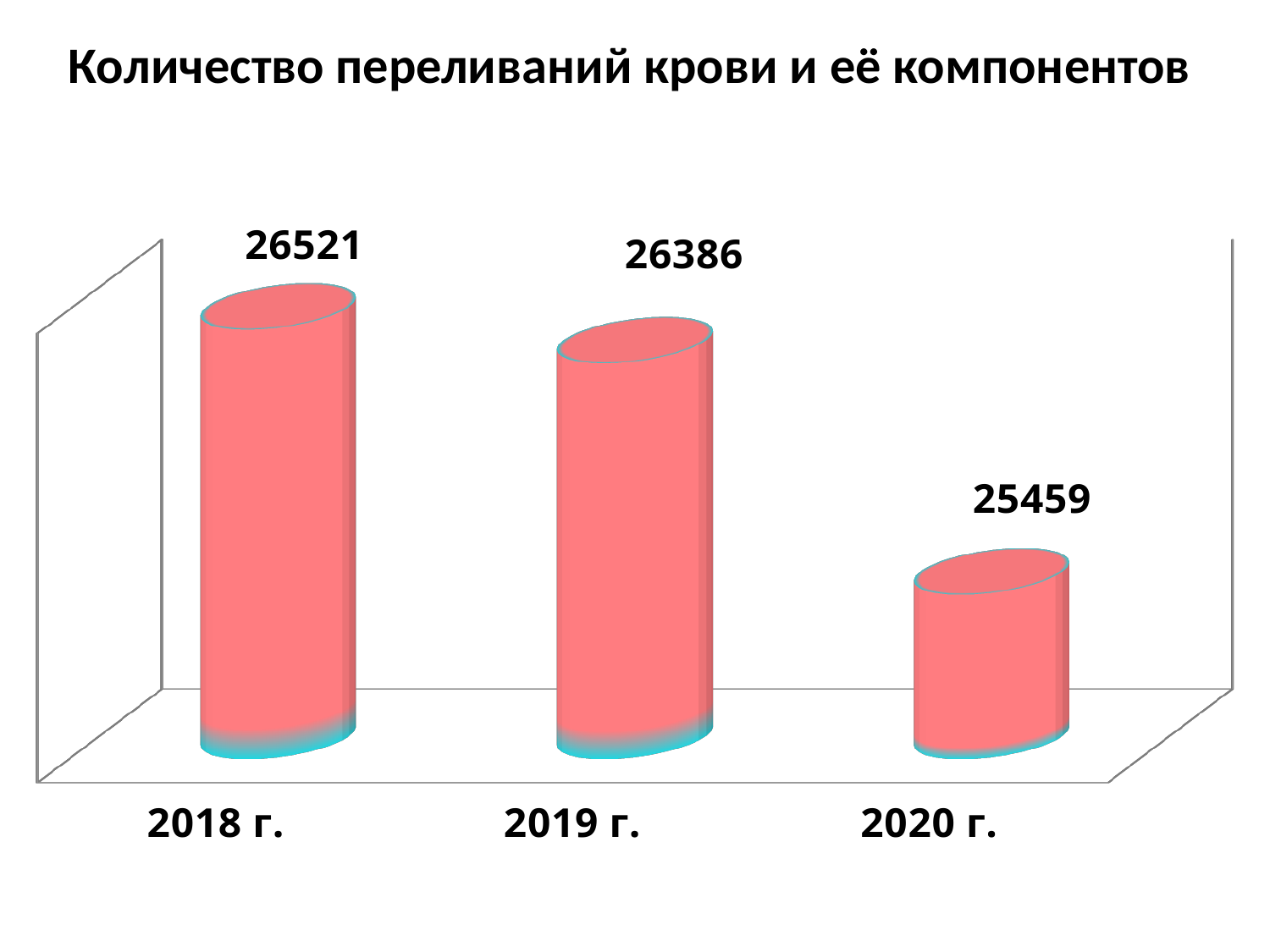
What is the difference between the values for 2019 г. and 2020 г.? 927 What is the difference between the values for 2018 г. and 2019 г.? 135 How many years are shown on the chart? 3 What kind of chart is shown on the slide? bar chart Which is larger, the value for 2019 г. or the value for 2020 г.? 2019 г. What is the value for 2019 г.? 26386 What is the value for 2020 г.? 25459 What is the value for 2018 г.? 26521 Which year has the lowest value? 2020 г. Do the values rise or fall from 2018 г. to 2020 г.? fall What is the difference between the values for 2018 г. and 2020 г.? 1062 Which year has the highest value? 2018 г.